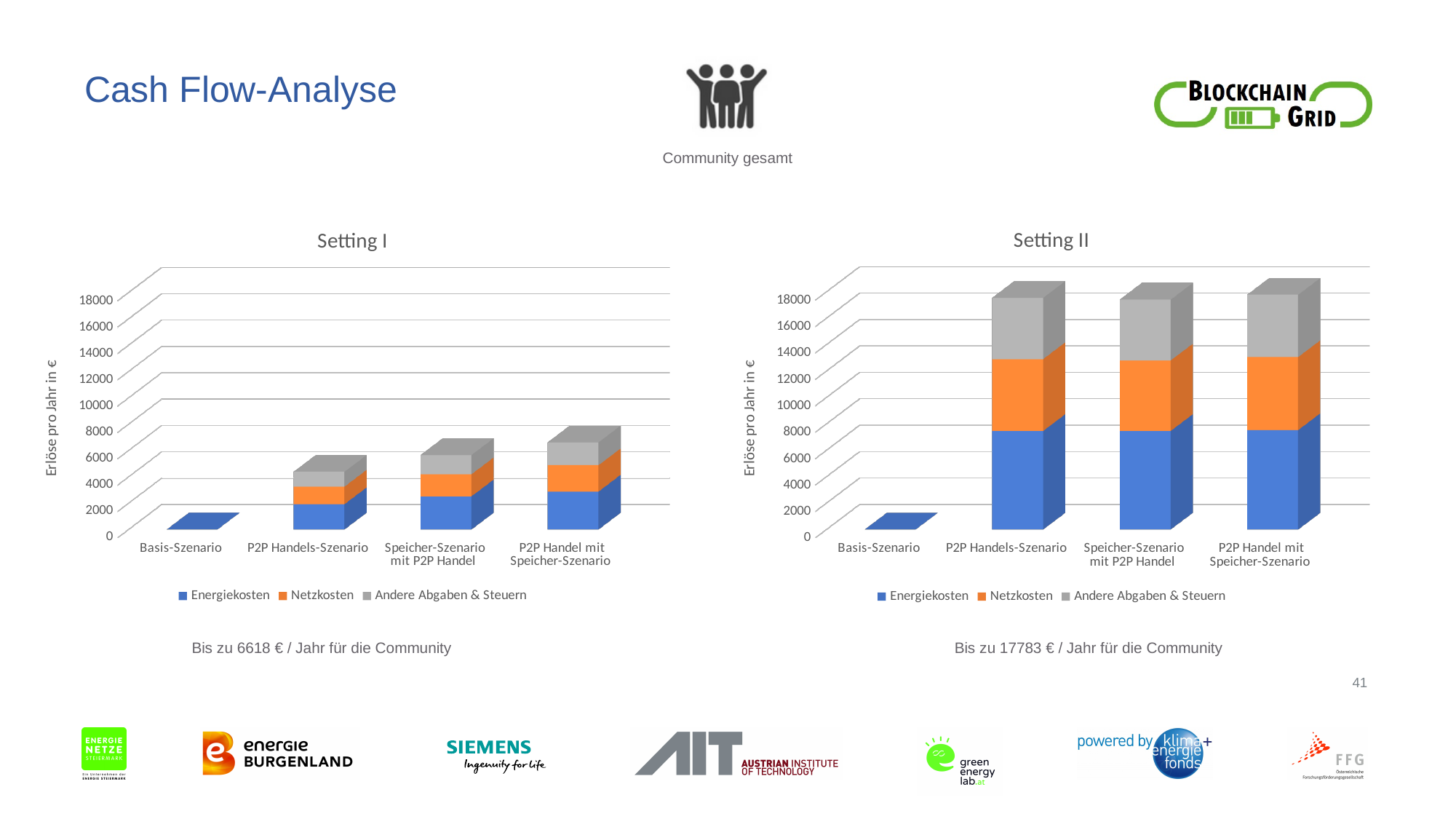
In the Setting I chart, which category has the lowest total? Basis-Szenario In the Setting I chart, do the totals rise or fall from left to right along the x axis? rise In the Setting I chart, is the total for P2P Handels-Szenario greater or less than 6000? less In the Setting II chart, which category has the lowest total? Basis-Szenario In the Setting II chart, is the total for P2P Handels-Szenario greater or less than 16000? greater In the Setting I chart, which category has the highest total? P2P Handel mit Speicher-Szenario Which is larger: the total for P2P Handels-Szenario in the Setting I chart or in the Setting II chart? Setting II What is the y-axis label of the Setting II chart? Erlöse pro Jahr in € How many categories are shown on the x axis of the Setting II chart? 4 How many series does the legend of the Setting I chart list? 3 In the Setting I chart, which is larger: the total for P2P Handels-Szenario or for P2P Handel mit Speicher-Szenario? P2P Handel mit Speicher-Szenario What kind of chart is the Setting I chart? stacked bar chart